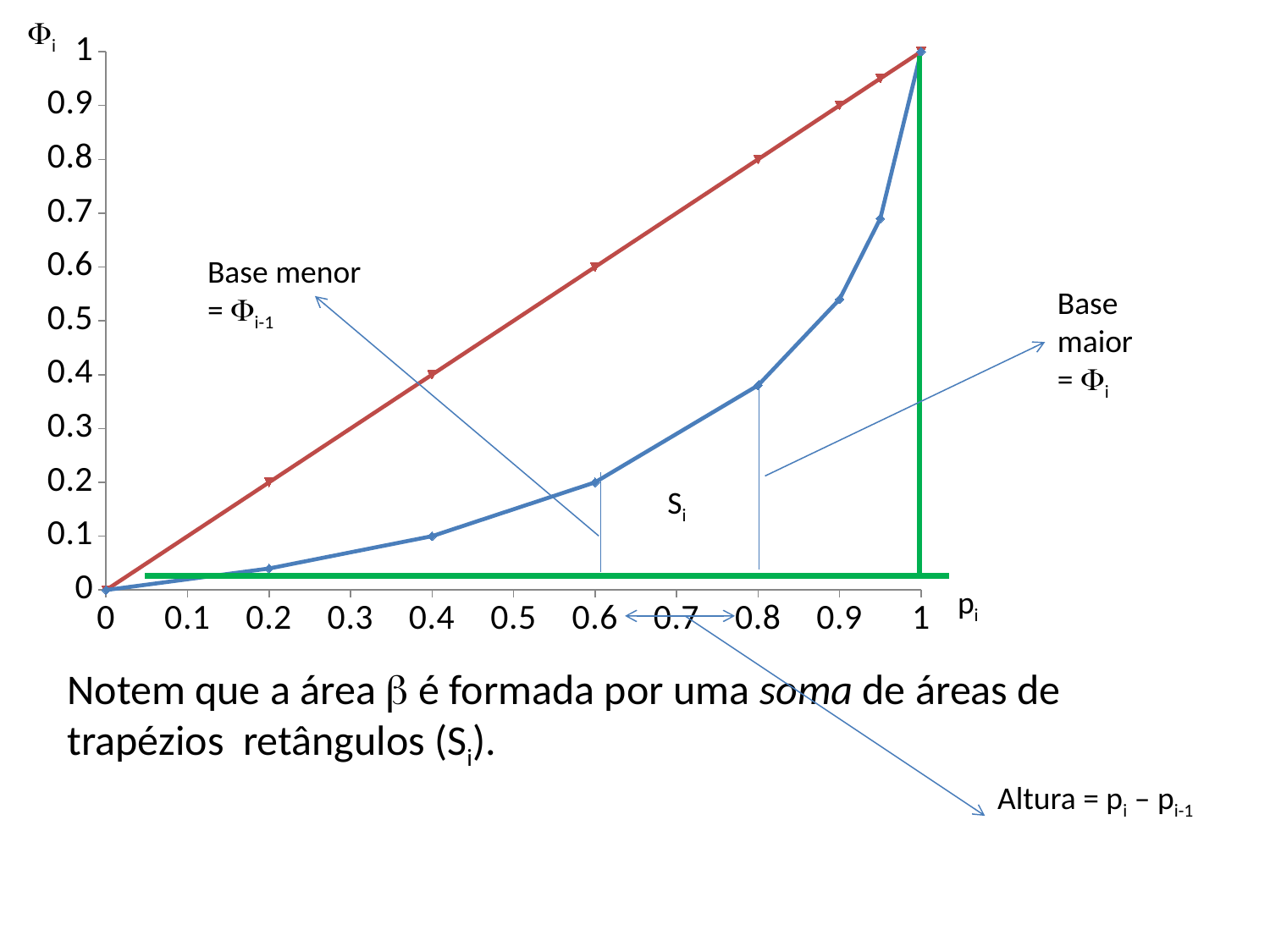
Is the value of the blue curve at p = 0.2 greater or less than 0.1? less What is the value of the blue curve at p = 1? 1 At p = 0.8, which series has the higher value, the red line or the blue curve? the red line What is the value of the blue curve at p = 0.6? 0.2 Is the value of the blue curve at p = 0.9 greater or less than 0.5? greater What is the value of the red line at p = 0.6? 0.6 What is the label of the horizontal axis? p_i What is the value of the blue curve at p = 0.4? 0.1 Does the blue curve rise or fall as p increases from 0 to 1? rises What kind of chart is shown on the slide? line chart What is the highest tick value shown on the vertical axis? 1 Is the value of the blue curve at p = 0.8 greater or less than 0.3? greater